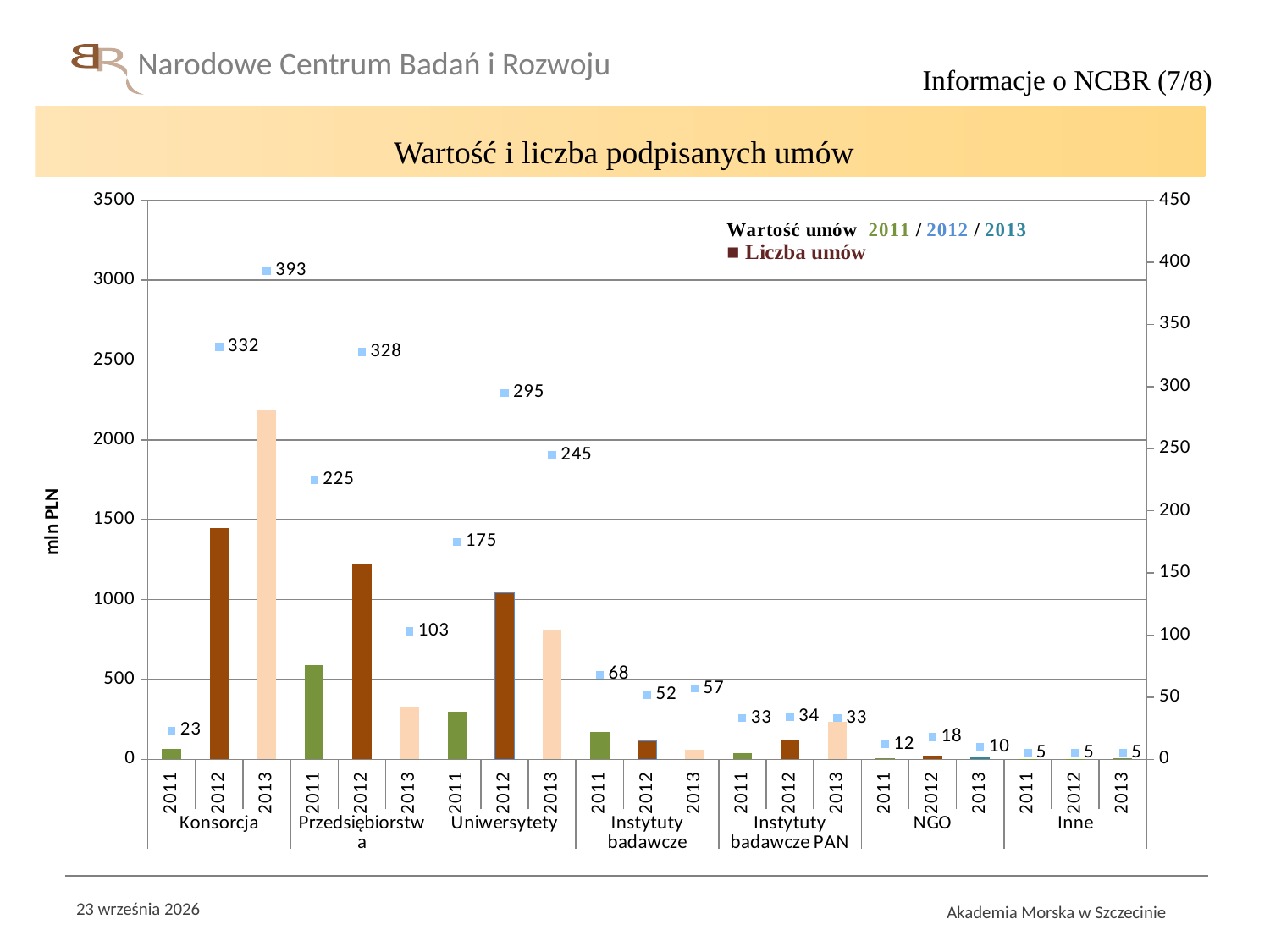
What is the label of the left vertical axis? mln PLN Is the value of contracts (bar, mln PLN) for Konsorcja in 2013 greater or less than 2000? greater What is the difference between the number of contracts for Konsorcja in 2013 and in 2012? 61 Which had more contracts in 2012: Uniwersytety or Przedsiębiorstwa? Przedsiębiorstwa How many contracts (Liczba umów) were signed with Konsorcja in 2013? 393 Does the number of contracts for Konsorcja rise or fall from 2011 to 2013? rise What is the number of contracts (Liczba umów) for Przedsiębiorstwa in 2011? 225 How many categories of contract partners are shown on the x axis? 7 What is the lowest number of contracts (Liczba umów) shown on the chart? 5 Is the value of contracts (bar, mln PLN) for Przedsiębiorstwa in 2013 greater or less than 500? less What is the number of contracts (Liczba umów) for Instytuty badawcze in 2011? 68 Which category and year has the highest number of contracts (Liczba umów)? Konsorcja 2013